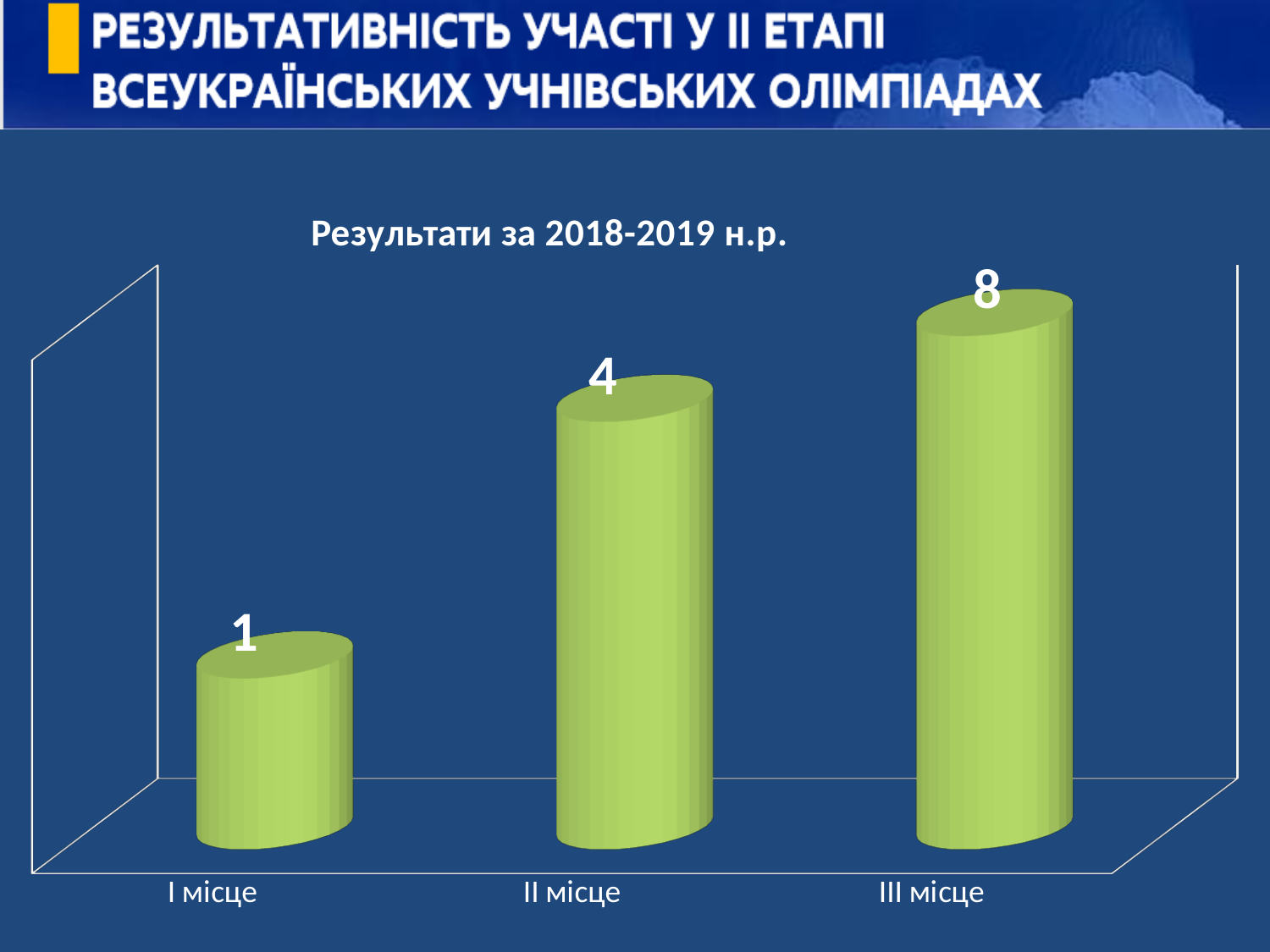
What is the title of the chart? Результати за 2018-2019 н.р. How many categories are shown on the chart? 3 What is the difference between the values for III місце and II місце? 4 What kind of chart is shown on the slide? bar chart What is the value for III місце? 8 What is the difference between the values for II місце and I місце? 3 Do the values rise or fall from I місце to III місце? rise What is the value for II місце? 4 Which is larger, the value for II місце or the value for I місце? II місце What is the value for I місце? 1 Which category has the highest value? III місце Which category has the lowest value? I місце